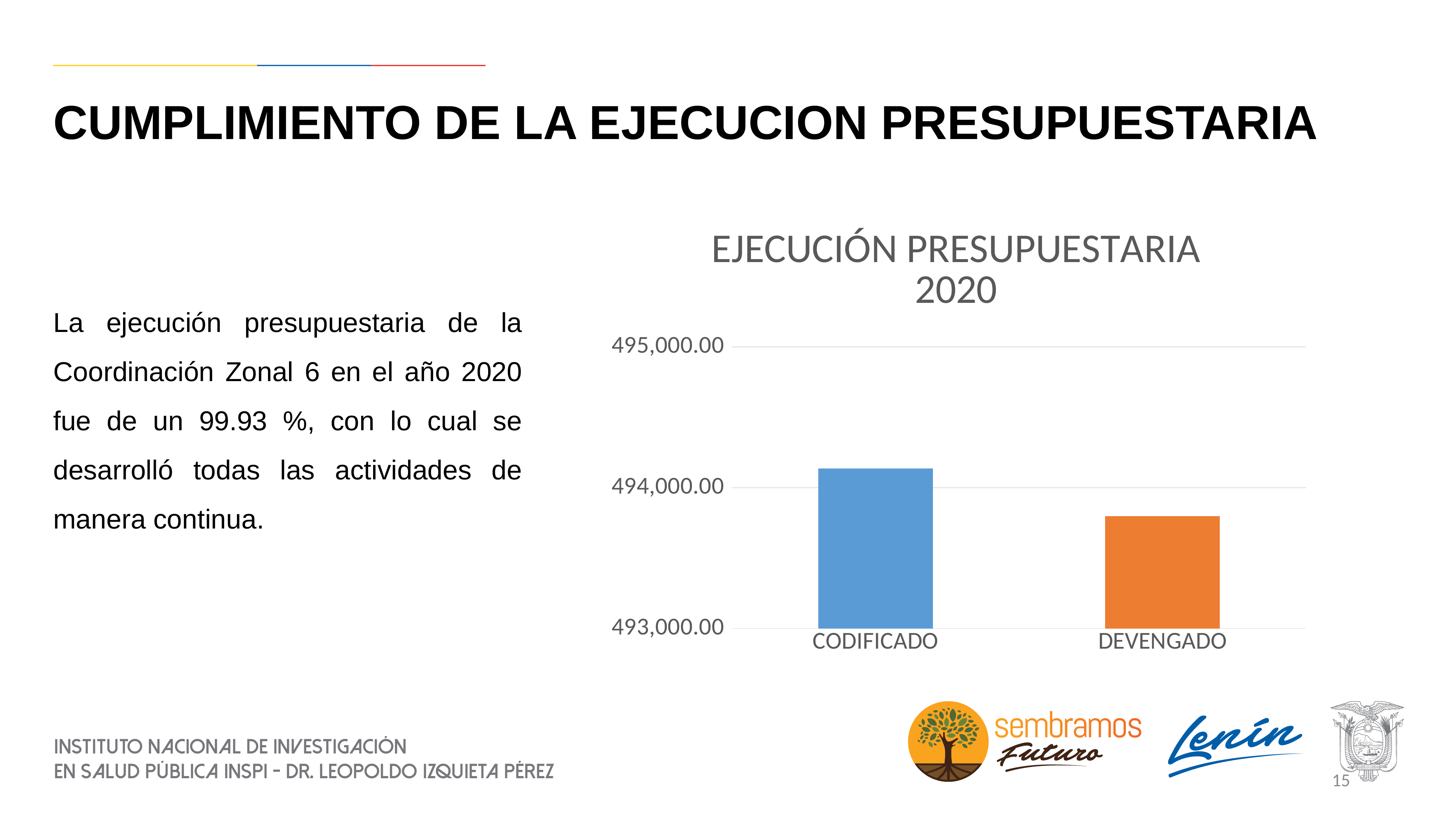
What colour is the bar for DEVENGADO? orange Which is larger, the value for CODIFICADO or the value for DEVENGADO? CODIFICADO Which category has the lowest value in the chart? DEVENGADO Is the value for DEVENGADO greater or less than 493,000.00? greater Is the value for CODIFICADO greater or less than 495,000.00? less Is the value for DEVENGADO greater or less than 494,000.00? less How many categories are plotted in the chart? 2 What is the title of the chart? EJECUCIÓN PRESUPUESTARIA 2020 What kind of chart is shown on the slide? bar chart Which category has the highest value in the chart? CODIFICADO